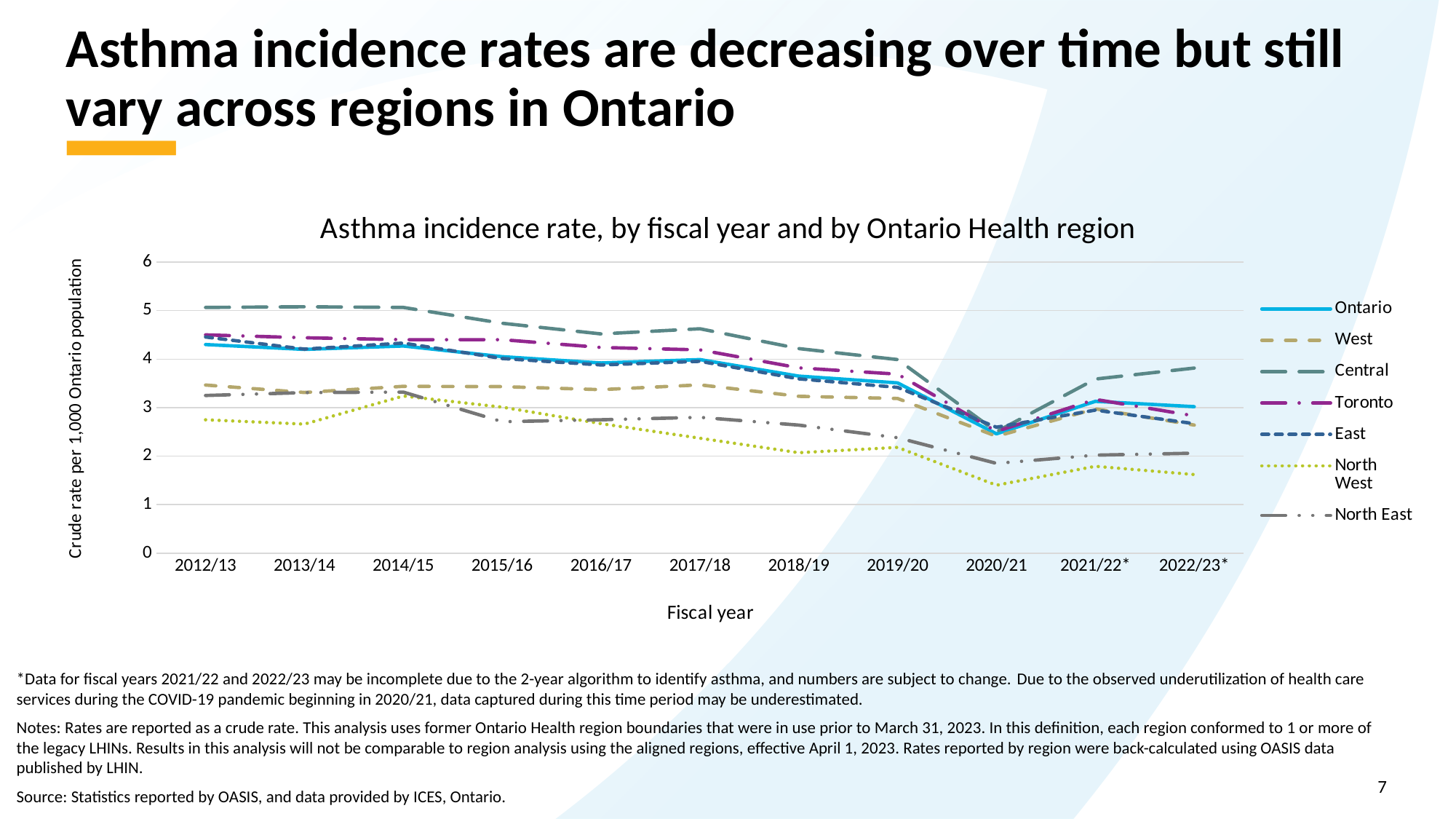
What is the title of the chart? Asthma incidence rate, by fiscal year and by Ontario Health region Is the value for North West in 2020/21 greater or less than 2? less Which region has the lowest asthma incidence rate in 2020/21? North West Which region has the lowest asthma incidence rate in 2012/13? North West Which region has the highest asthma incidence rate in 2012/13? Central Which is larger in 2017/18, the value for Central or the value for North West? Central Is the value for Central in 2012/13 greater or less than 4? greater How many fiscal years are shown on the x axis? 11 How many series does the legend list? 7 What kind of chart is shown on the slide? line chart Does the Ontario line rise or fall from 2012/13 to 2020/21? fall Is the value for Ontario in 2020/21 greater or less than 3? less